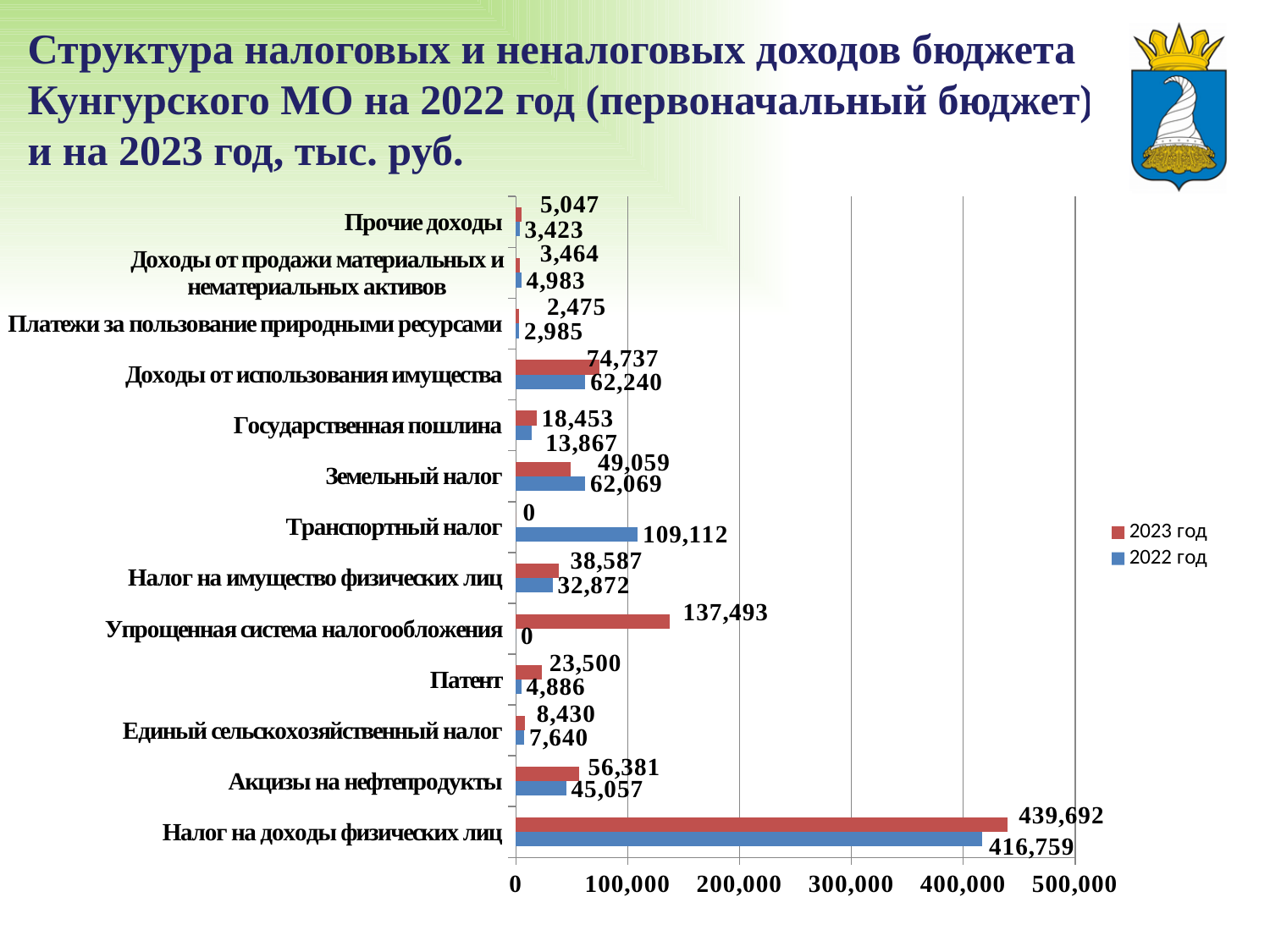
How many series does the legend list? 2 What is the value for Упрощенная система налогообложения in the 2023 год series? 137,493 What is the value for Налог на доходы физических лиц in the 2023 год series? 439,692 Which colour represents the 2023 год series in the chart? red What is the value for Транспортный налог in the 2022 год series? 109,112 How many categories are shown on the chart? 13 What is the difference between the 2023 год and 2022 год values for Акцизы на нефтепродукты? 11,324 What kind of chart is shown on the slide? bar chart Which category has the lowest value in the 2023 год series? Транспортный налог Which is larger for Земельный налог: the 2023 год value or the 2022 год value? 2022 год Is the 2023 год value for Доходы от использования имущества greater or less than 100,000? less Which category has the highest value in the 2022 год series? Налог на доходы физических лиц